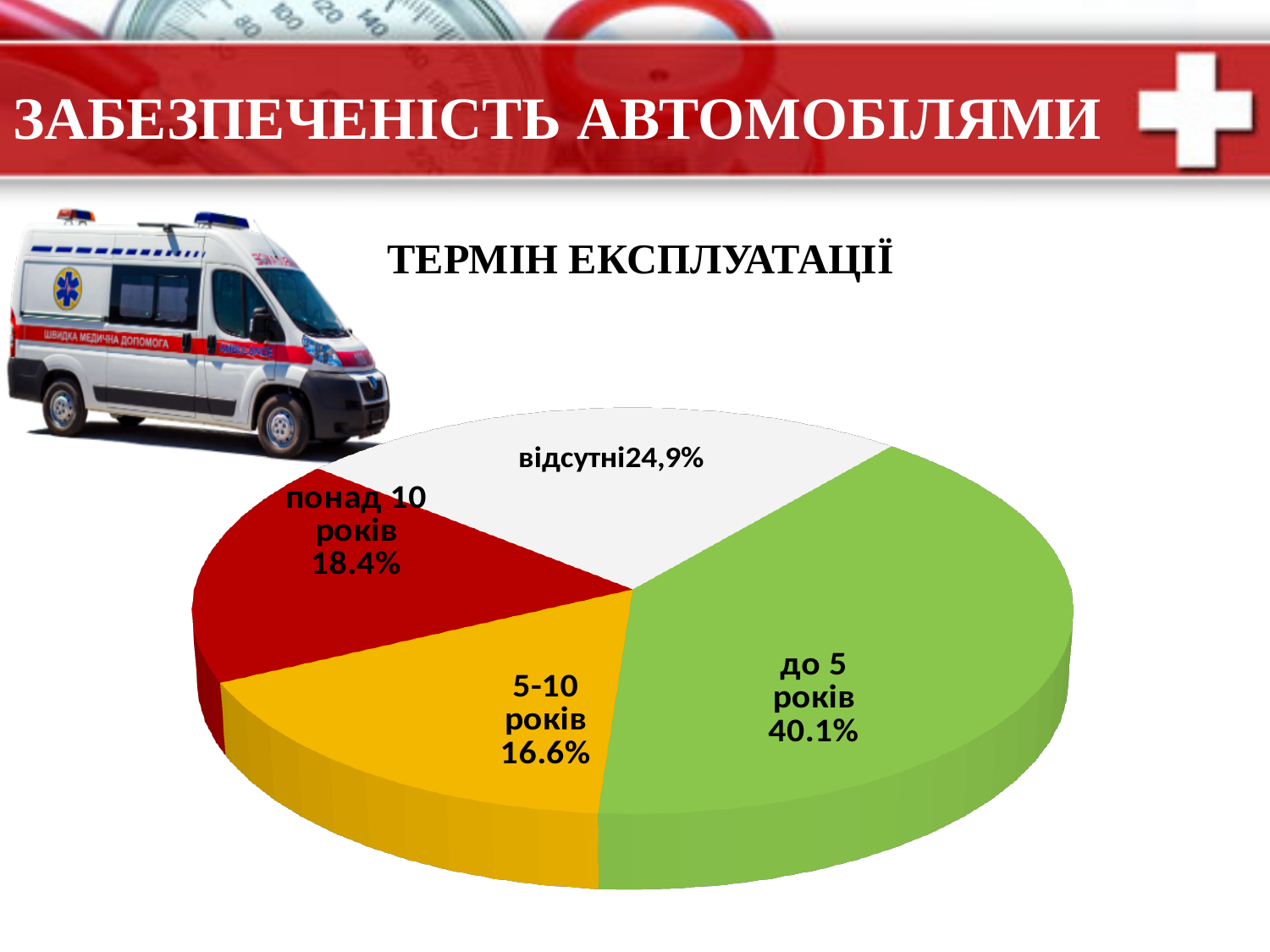
What share of the pie is labelled "до 5 років"? 40.1% What is the title of the pie chart? ТЕРМІН ЕКСПЛУАТАЦІЇ Which category has the largest share of the pie? до 5 років What share of the pie is labelled "понад 10 років"? 18.4% Which is larger: the share for "понад 10 років" or the share for "5-10 років"? понад 10 років What share of the pie is labelled "відсутні"? 24,9% How many slices does the pie chart have? 4 What type of chart is shown on the slide? pie chart Which category has the smallest share of the pie? 5-10 років What share of the pie is labelled "5-10 років"? 16.6% What is the difference in percentage points between "до 5 років" and "5-10 років"? 23.5 What colour is the slice for "до 5 років"? green